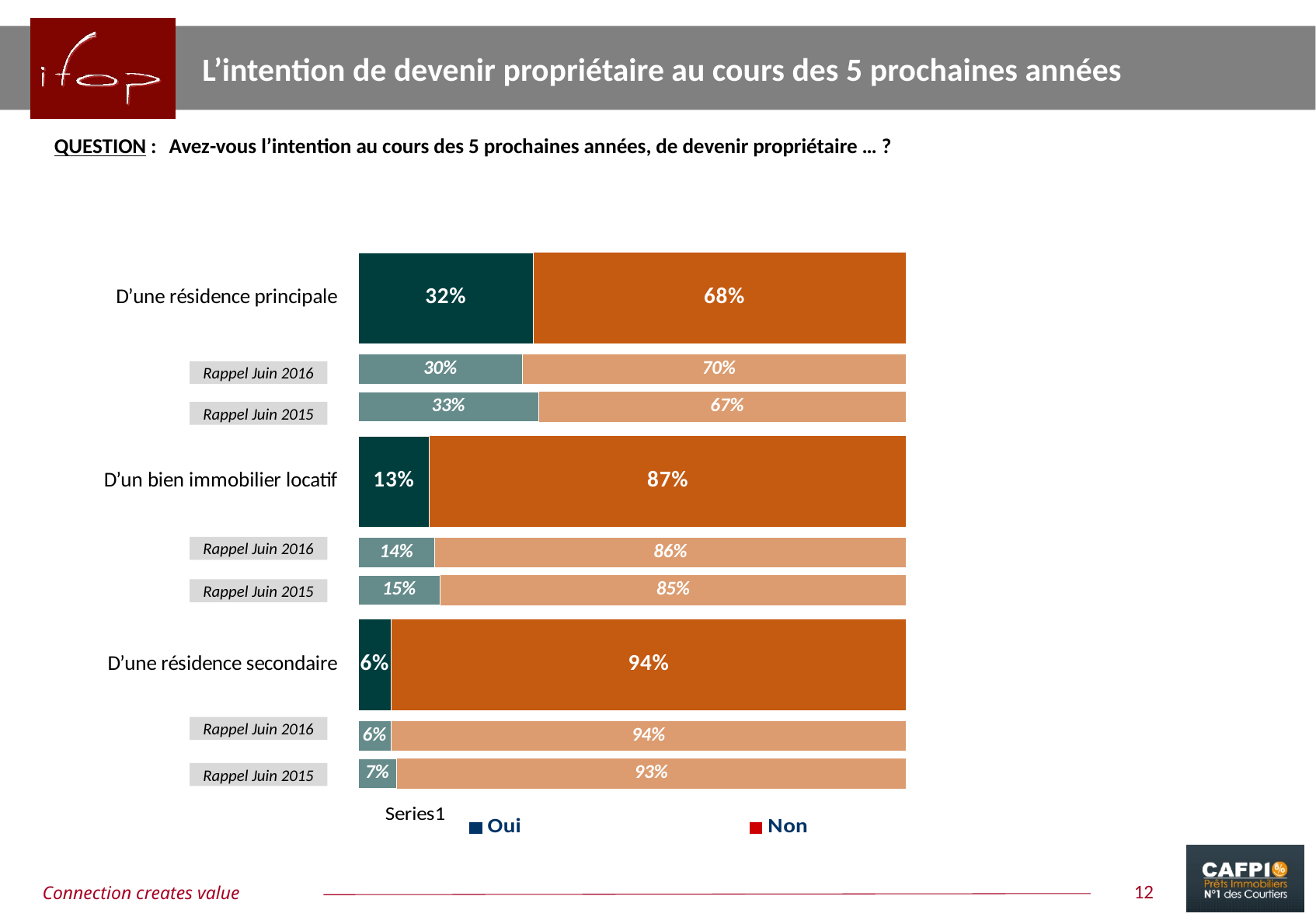
Which of the three main categories has the highest "Oui" share in the current wave? D'une résidence principale Which of the three main categories has the lowest "Oui" share in the current wave? D'une résidence secondaire What was the "Oui" share for "D'une résidence secondaire" in the Rappel Juin 2015 row? 7% How many main categories (excluding the Rappel rows) are shown in the chart? 3 What kind of chart is shown on the slide? Stacked bar chart What percentage of respondents answered "Oui" for "D'une résidence principale" in the current wave? 32% What is the difference between the "Non" share for "D'une résidence secondaire" and for "D'une résidence principale" in the current wave? 26 percentage points What are the two legend entries of the chart? Oui and Non How many series does the legend list? 2 What percentage answered "Non" for "D'un bien immobilier locatif" in the current wave? 87% Is the "Oui" share for "D'un bien immobilier locatif" larger in the current wave or in Rappel Juin 2015? Rappel Juin 2015 What was the "Non" share for "D'une résidence principale" in the Rappel Juin 2016 row? 70%